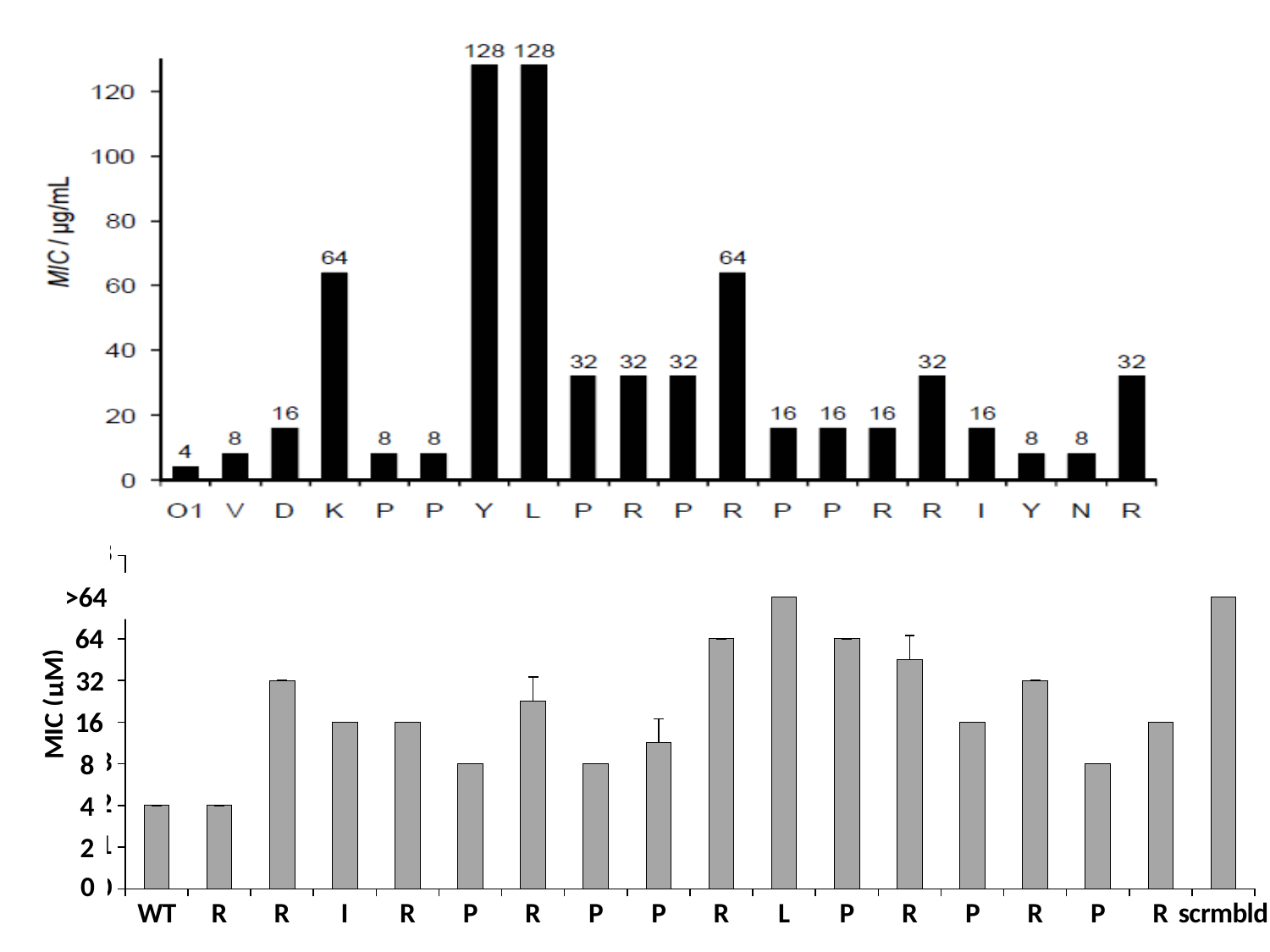
What is the y-axis label of the bottom chart? MIC (µM) How many bars are shown in the top chart? 20 In the top chart, what is the MIC value for O1? 4 In the top chart, what is the difference between the MIC values for K and O1? 60 In the top chart, what is the MIC value for D? 16 In the top chart, which has the larger MIC value, K or D? K What kind of chart is the top chart? Bar chart In the top chart, what is the MIC value for K? 64 In the top chart, which category has the lowest MIC value? O1 In the top chart, what is the highest MIC value shown? 128 In the bottom chart, what is the MIC value for I? 16 In the bottom chart, what is the MIC value for WT? 4